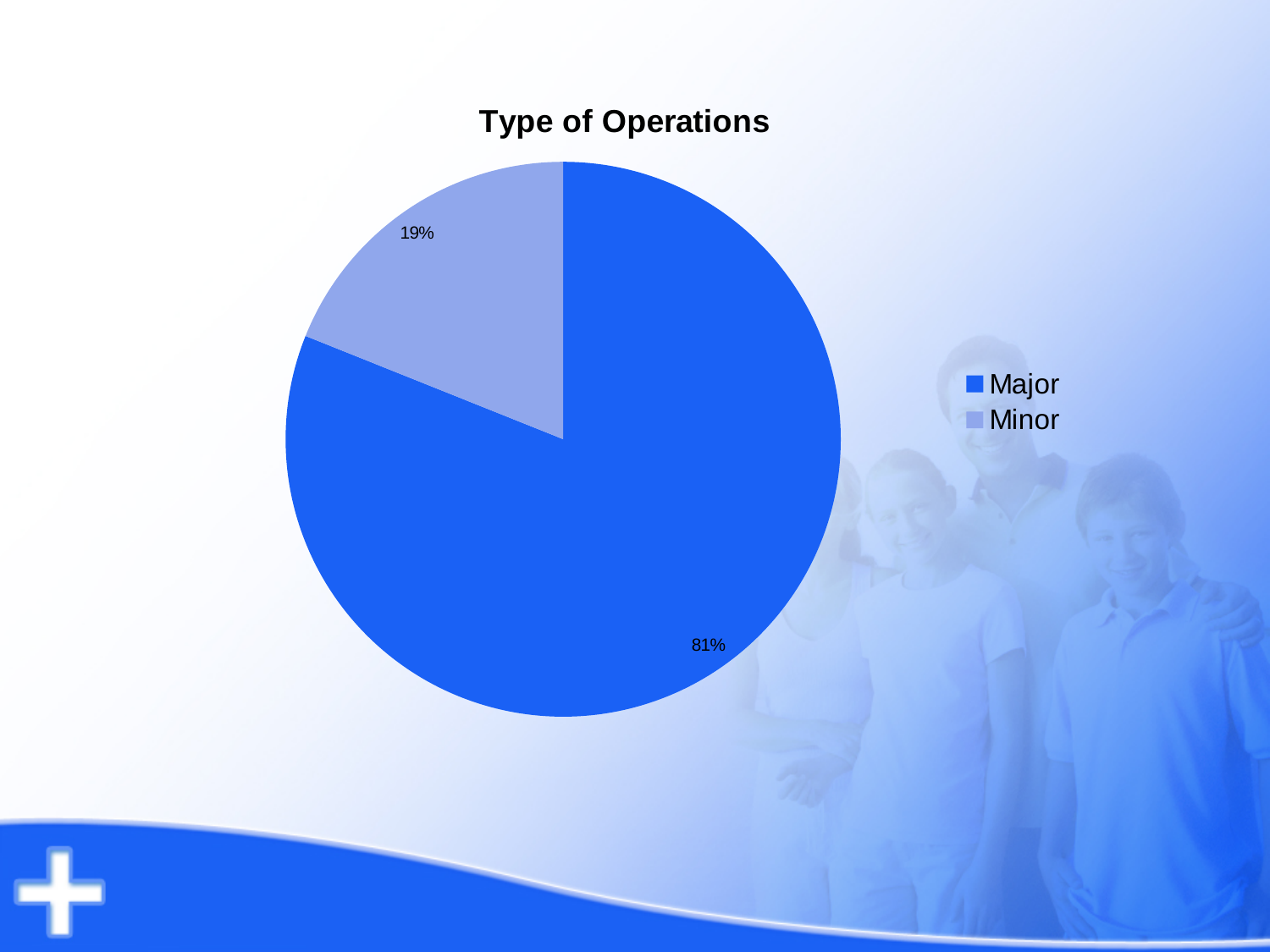
Which category has the largest share of the pie? Major What is the title of the chart? Type of Operations What is the difference in percentage points between the Major and Minor shares? 62 What share of the pie is Major? 81% How many entries does the legend list? 2 Which category has the smallest share of the pie? Minor How many categories does the pie chart show? 2 What share of the pie is Minor? 19% Which is larger, the share for Major or the share for Minor? Major Which legend entry is shown in the lighter blue colour? Minor What kind of chart is shown on the slide? pie chart